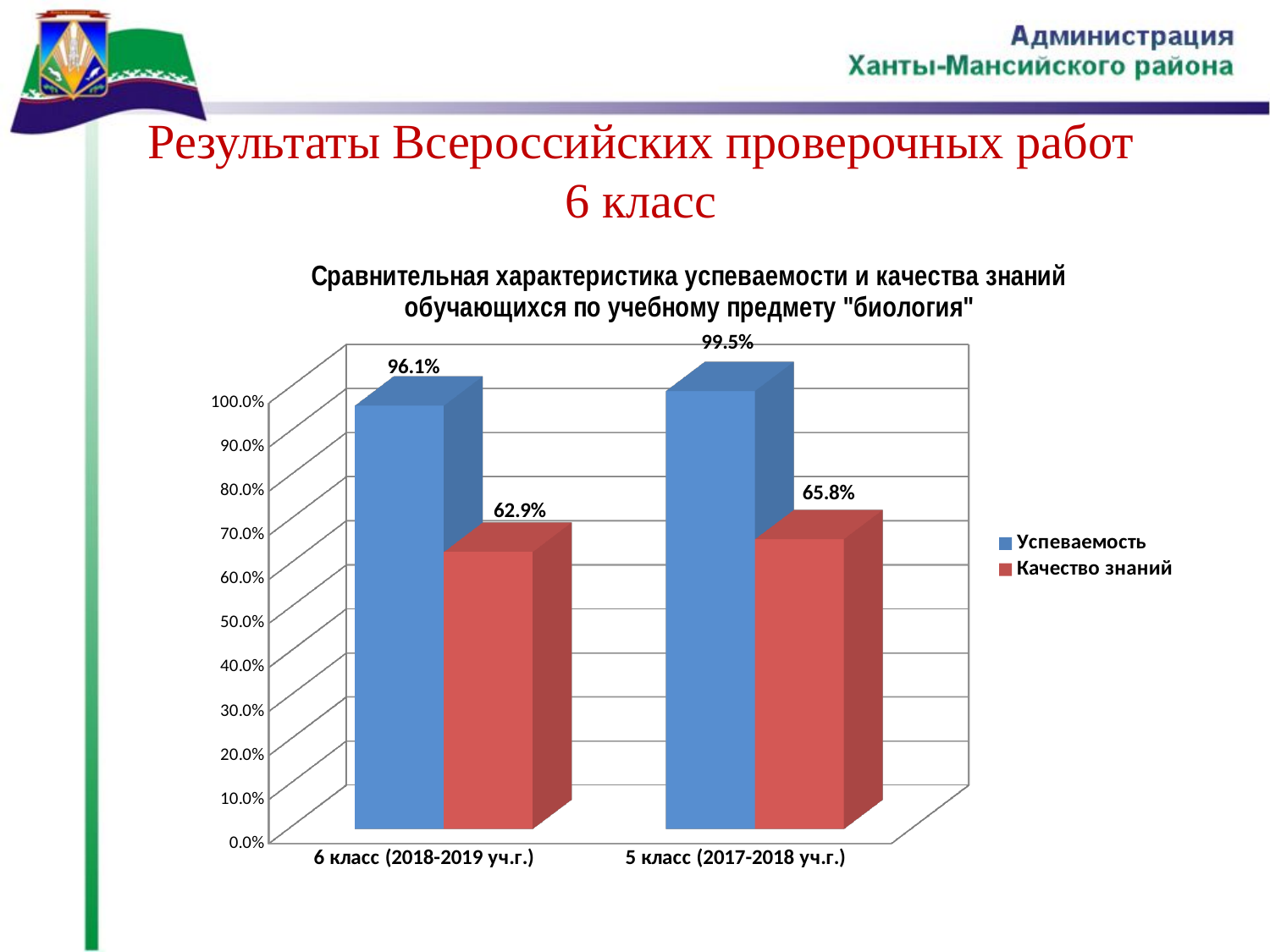
How many categories are shown on the x axis? 2 Is Качество знаний for 5 класс (2017-2018 уч.г.) larger or smaller than Качество знаний for 6 класс (2018-2019 уч.г.)? larger How many series does the legend list? 2 What is the value of Успеваемость for 5 класс (2017-2018 уч.г.)? 99.5% What kind of chart is shown on the slide? bar chart What is the value of Успеваемость for 6 класс (2018-2019 уч.г.)? 96.1% What is the difference between Успеваемость and Качество знаний for 6 класс (2018-2019 уч.г.)? 33.2% What is the difference between the Успеваемость values for 5 класс (2017-2018 уч.г.) and 6 класс (2018-2019 уч.г.)? 3.4% What is the value of Качество знаний for 5 класс (2017-2018 уч.г.)? 65.8% Which category has the lower Качество знаний value? 6 класс (2018-2019 уч.г.) What is the value of Качество знаний for 6 класс (2018-2019 уч.г.)? 62.9% Which category has the higher Успеваемость value? 5 класс (2017-2018 уч.г.)